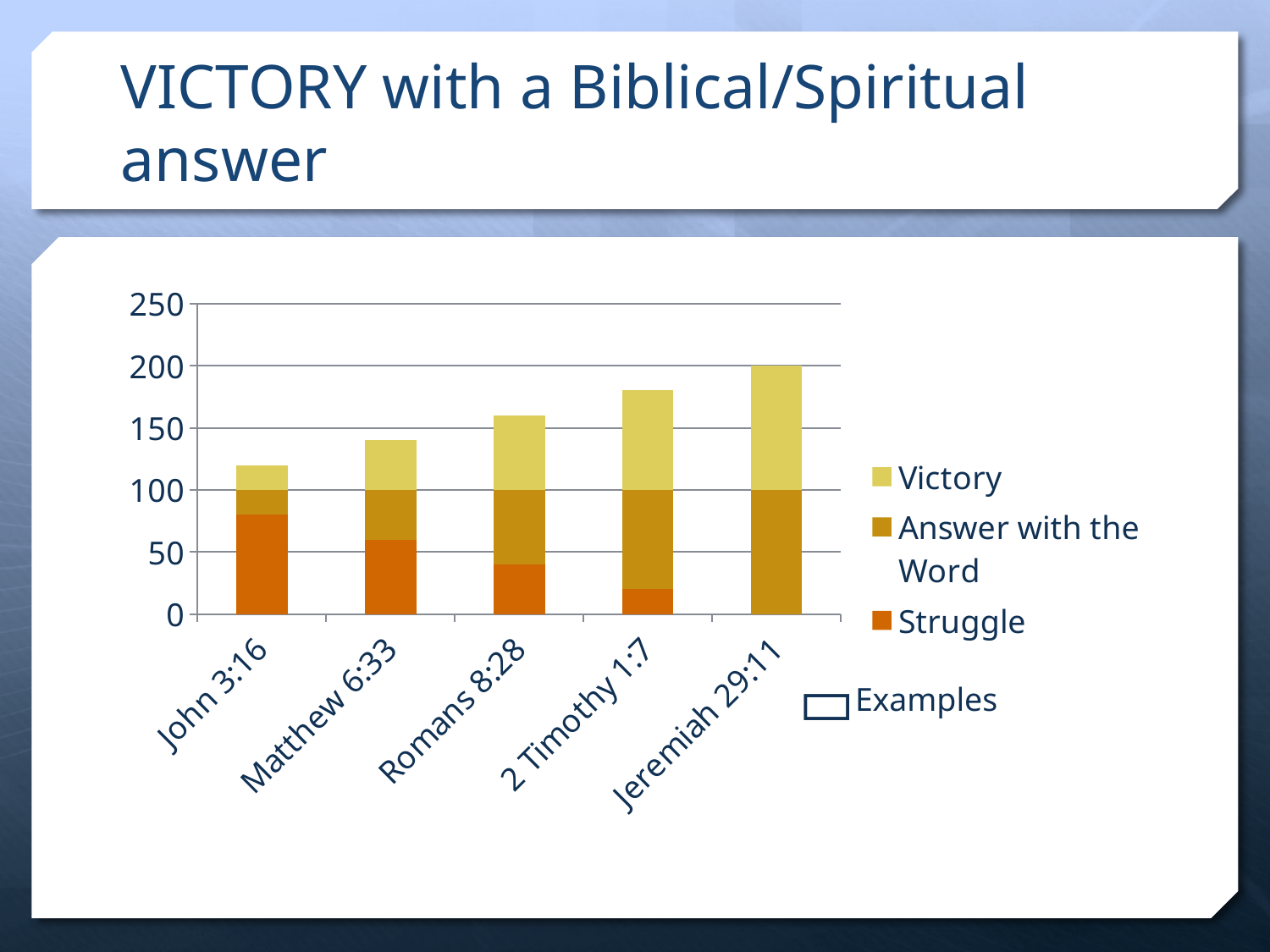
Which category has the shortest stacked bar? John 3:16 Which series is shown in the darkest orange colour in the legend? Struggle How many categories are shown on the x axis of the chart? 5 What label appears in the box below the legend? Examples How many series does the chart's legend list? 3 What kind of chart is shown on the slide? Stacked bar chart Is the Struggle value for John 3:16 greater or less than 50? greater Which category has the tallest stacked bar? Jeremiah 29:11 What is the total height of the stacked bar for Jeremiah 29:11? 200 Do the total bar heights rise or fall from John 3:16 to Jeremiah 29:11? Rise Is the total bar height for John 3:16 greater or less than 150? less Which category has a larger Struggle value, Matthew 6:33 or 2 Timothy 1:7? Matthew 6:33